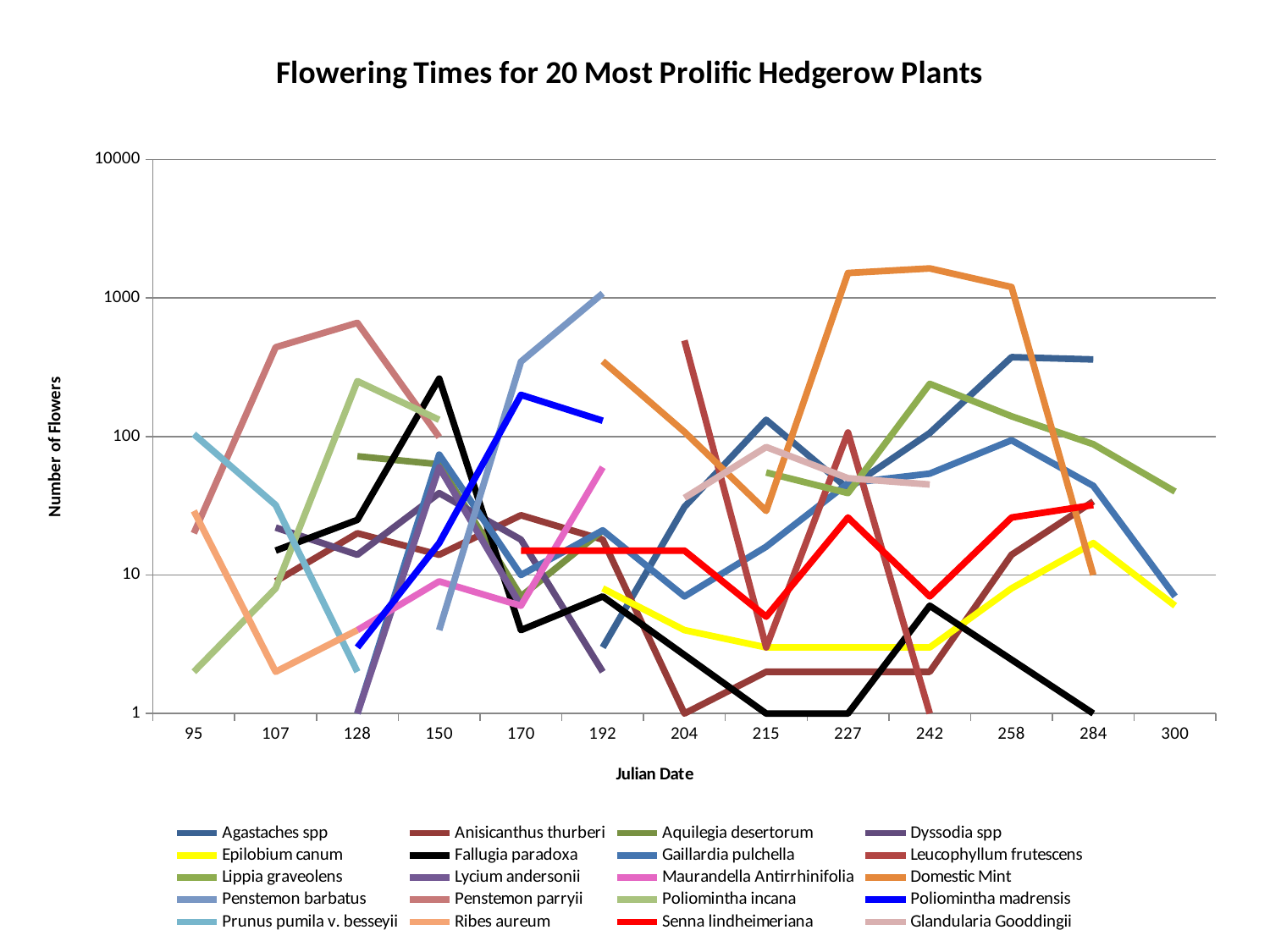
Is the value for Penstemon parryii at Julian date 128 greater or less than 100? greater Is the value for Domestic Mint at Julian date 242 greater or less than 1000? greater Is the value for Agastaches spp at Julian date 258 greater or less than 100? greater How many series does the legend list? 20 How many Julian date categories are shown on the x axis? 13 Which series reaches the highest number of flowers on the chart? Domestic Mint Which is larger: Domestic Mint at Julian date 242 or Agastaches spp at Julian date 258? Domestic Mint at 242 Does the value for Epilobium canum rise or fall from Julian date 192 to 215? fall What kind of chart is shown on the slide? line chart What is the title of the chart? Flowering Times for 20 Most Prolific Hedgerow Plants What is the label of the y axis? Number of Flowers